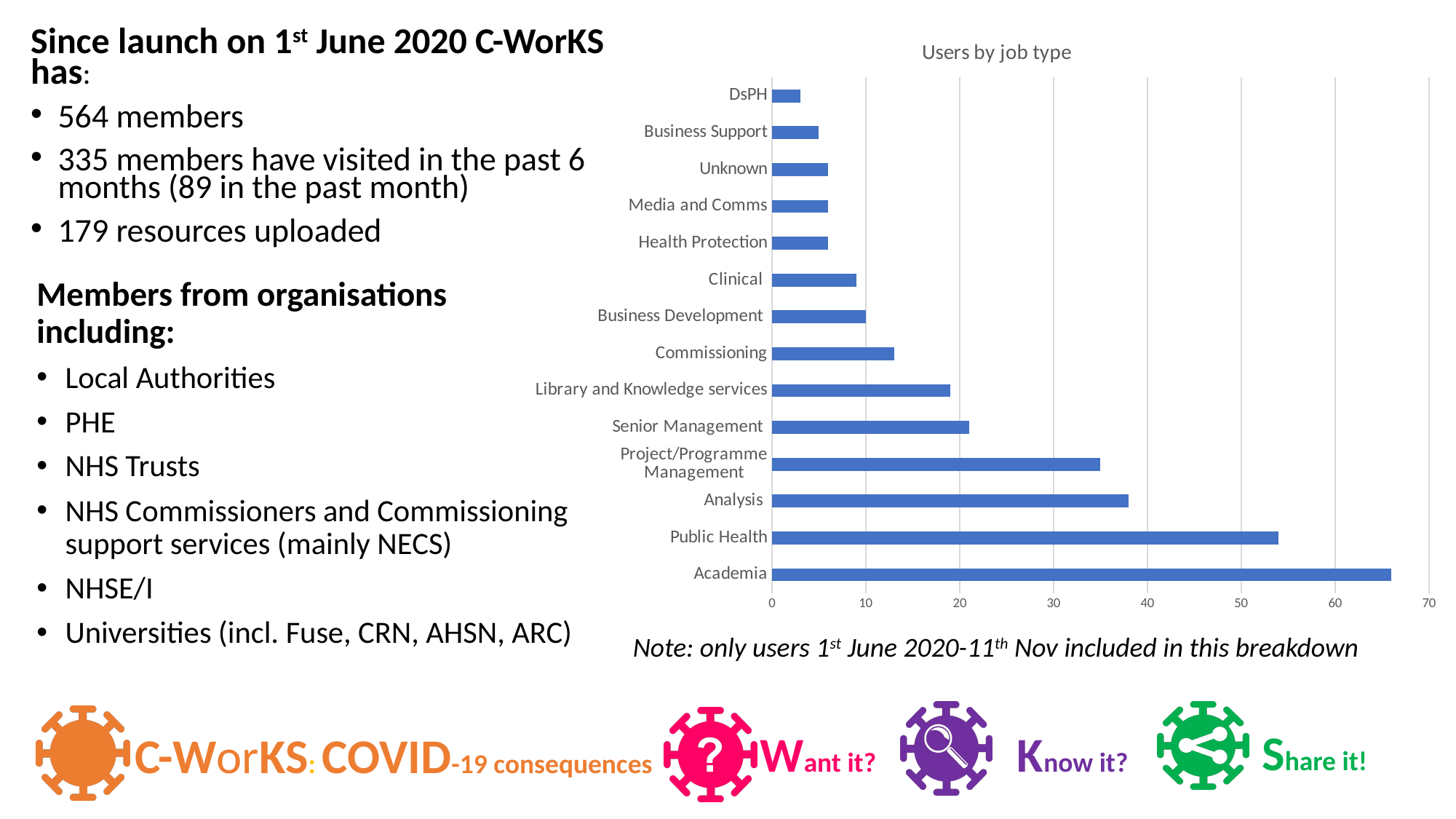
Which job type has the lowest number of users? DsPH Which job type has the highest number of users? Academia Which has more users, Public Health or Analysis? Public Health What type of chart is shown on the slide? bar chart Is the value for Academia greater or less than 60? greater Is the value for Analysis greater or less than 40? less What is the title of the chart? Users by job type Is the value for Commissioning greater or less than 10? greater Which has more users, Library and Knowledge services or Clinical? Library and Knowledge services How many job type categories are shown in the chart? 14